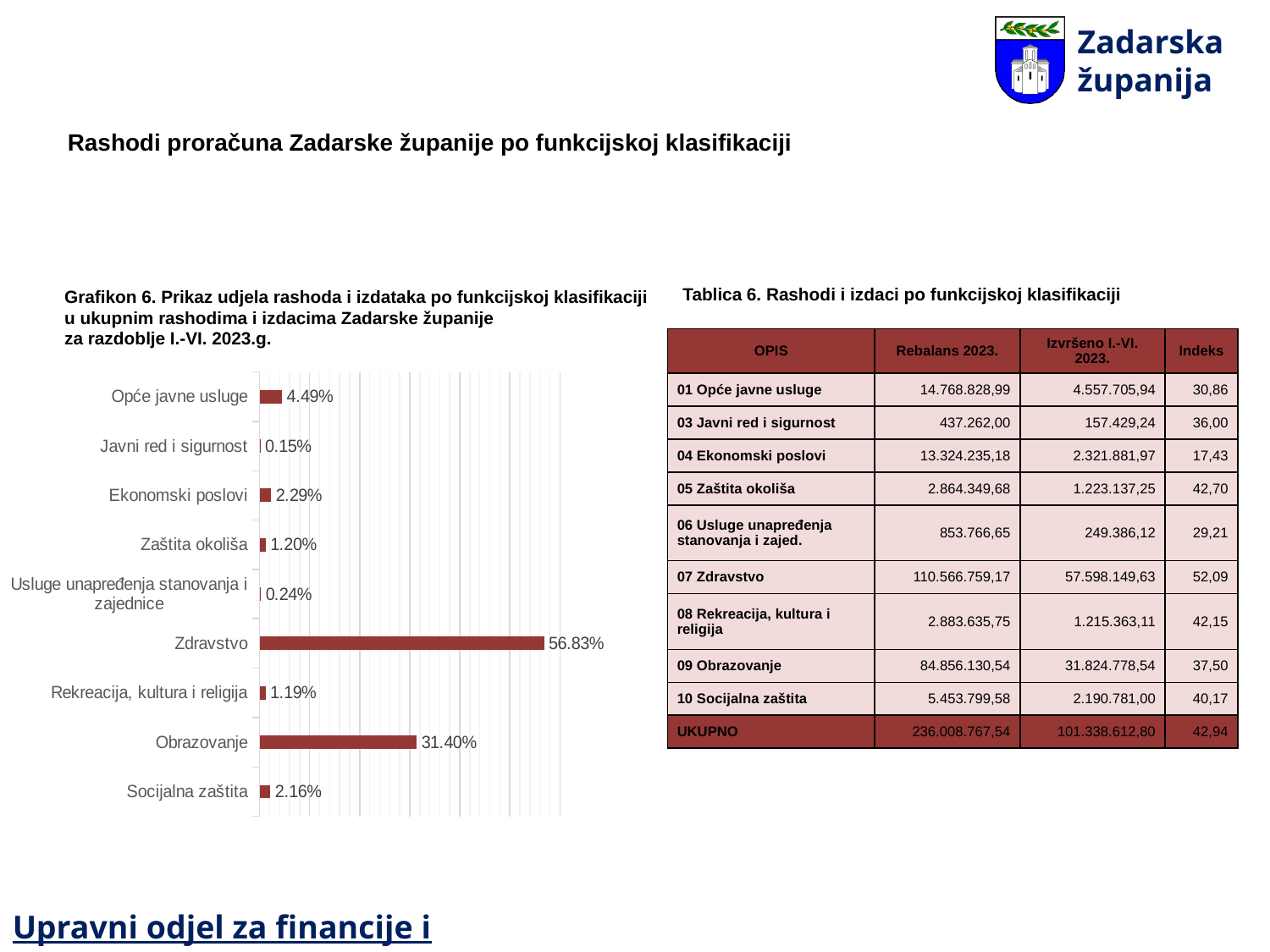
What is the difference between the values for Opće javne usluge and Ekonomski poslovi in the bar chart? 2.20% Which category has the highest value in the bar chart? Zdravstvo What is the value for Opće javne usluge in the bar chart? 4.49% What is the difference between the values for Zdravstvo and Obrazovanje in the bar chart? 25.43% What is the value for Zaštita okoliša in the bar chart? 1.20% How many categories are shown in the bar chart? 9 Which is larger in the bar chart: Ekonomski poslovi or Socijalna zaštita? Ekonomski poslovi Which category has the lowest value in the bar chart? Javni red i sigurnost What kind of chart is shown on the slide? Bar chart What is the value for Zdravstvo in the bar chart? 56.83% What is the value for Socijalna zaštita in the bar chart? 2.16% What is the value for Obrazovanje in the bar chart? 31.40%